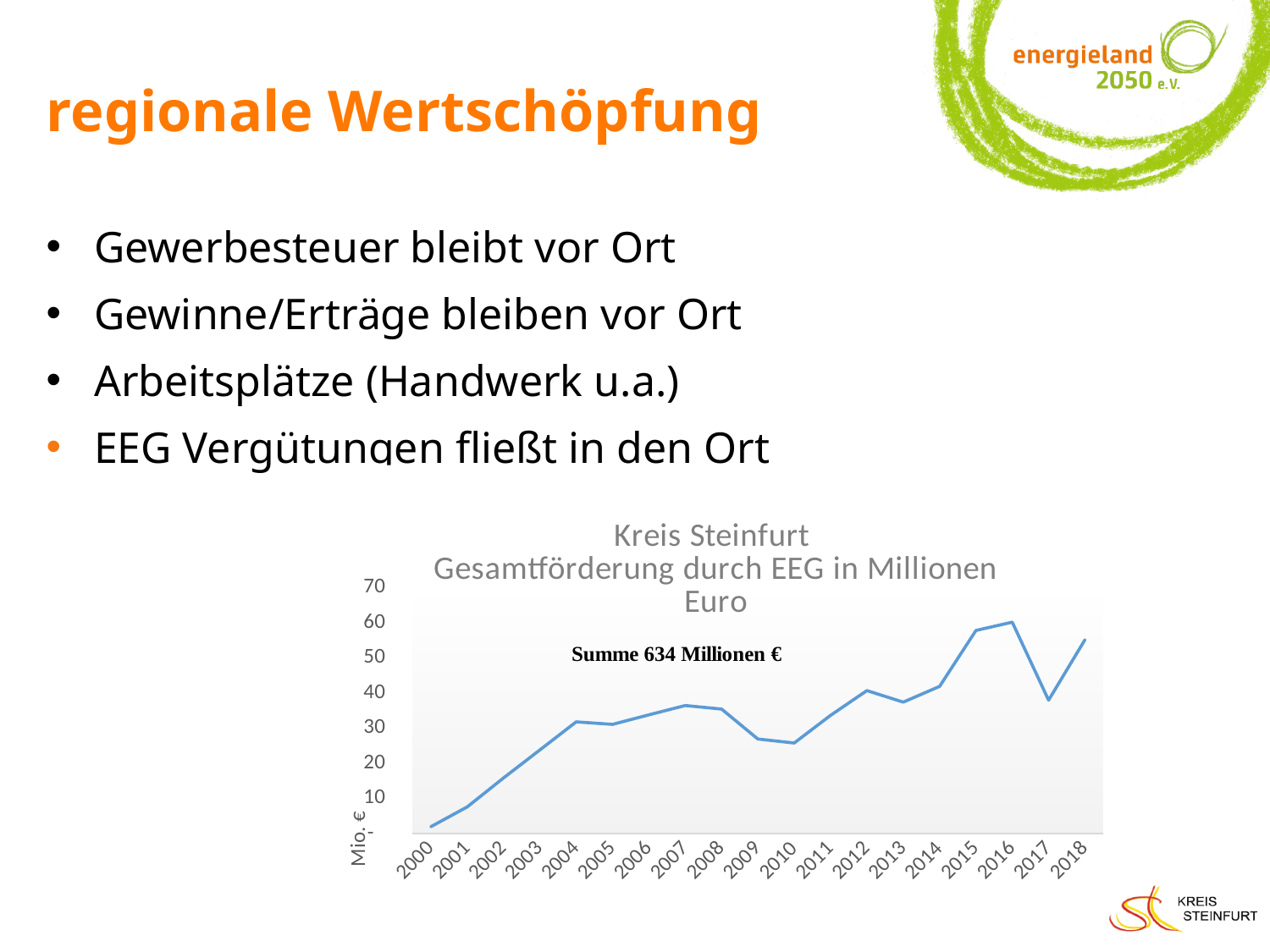
What is the title of the chart? Kreis Steinfurt Gesamtförderung durch EEG in Millionen Euro Is the value for 2016 greater or less than 50? greater Is the value for 2010 greater or less than 30? less Is the value for 2018 greater or less than 50? greater What kind of chart is shown on the slide? line chart Which year has the lowest value in the chart? 2000 What total sum is printed inside the chart? Summe 634 Millionen € Overall, do the values rise or fall from 2000 to 2018? rise How many years are plotted along the x axis of the chart? 19 Which year has the larger value, 2010 or 2012? 2012 Which year has the larger value, 2016 or 2017? 2016